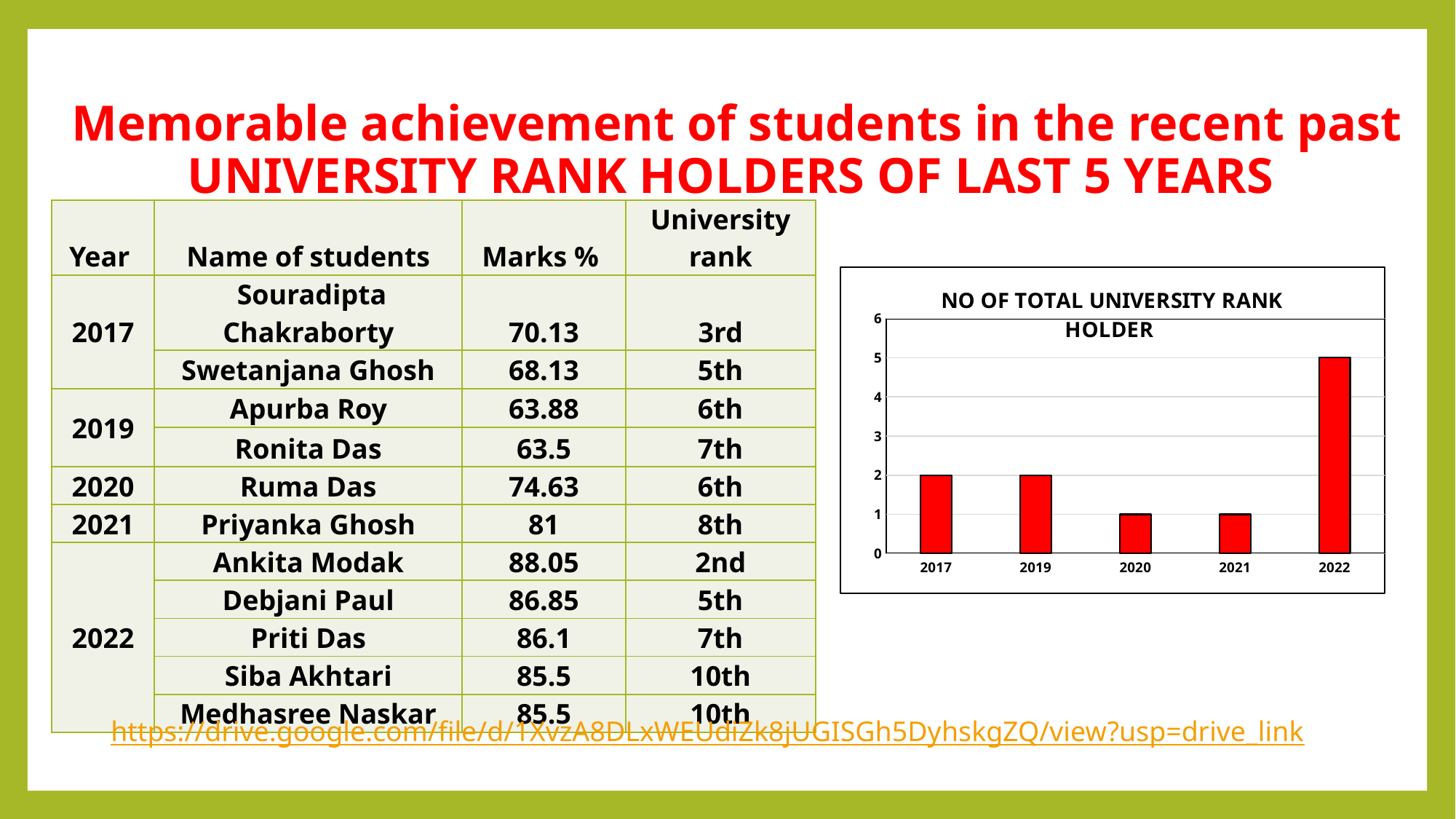
What is the number of university rank holders for 2017 in the chart? 2 Is the value for 2022 in the chart greater or less than 4? greater Which year has the highest number of university rank holders in the chart? 2022 What is the maximum value shown on the y axis of the chart? 6 What is the number of university rank holders for 2022 in the chart? 5 How many years are shown on the x axis of the chart? 5 What is the difference between the values for 2022 and 2017 in the chart? 3 Is the value for 2021 in the chart greater or less than 2? less What kind of chart is shown on the slide? bar chart What is the number of university rank holders for 2020 in the chart? 1 Which is larger in the chart, the value for 2019 or the value for 2021? 2019 What is the title of the chart? NO OF TOTAL UNIVERSITY RANK HOLDER